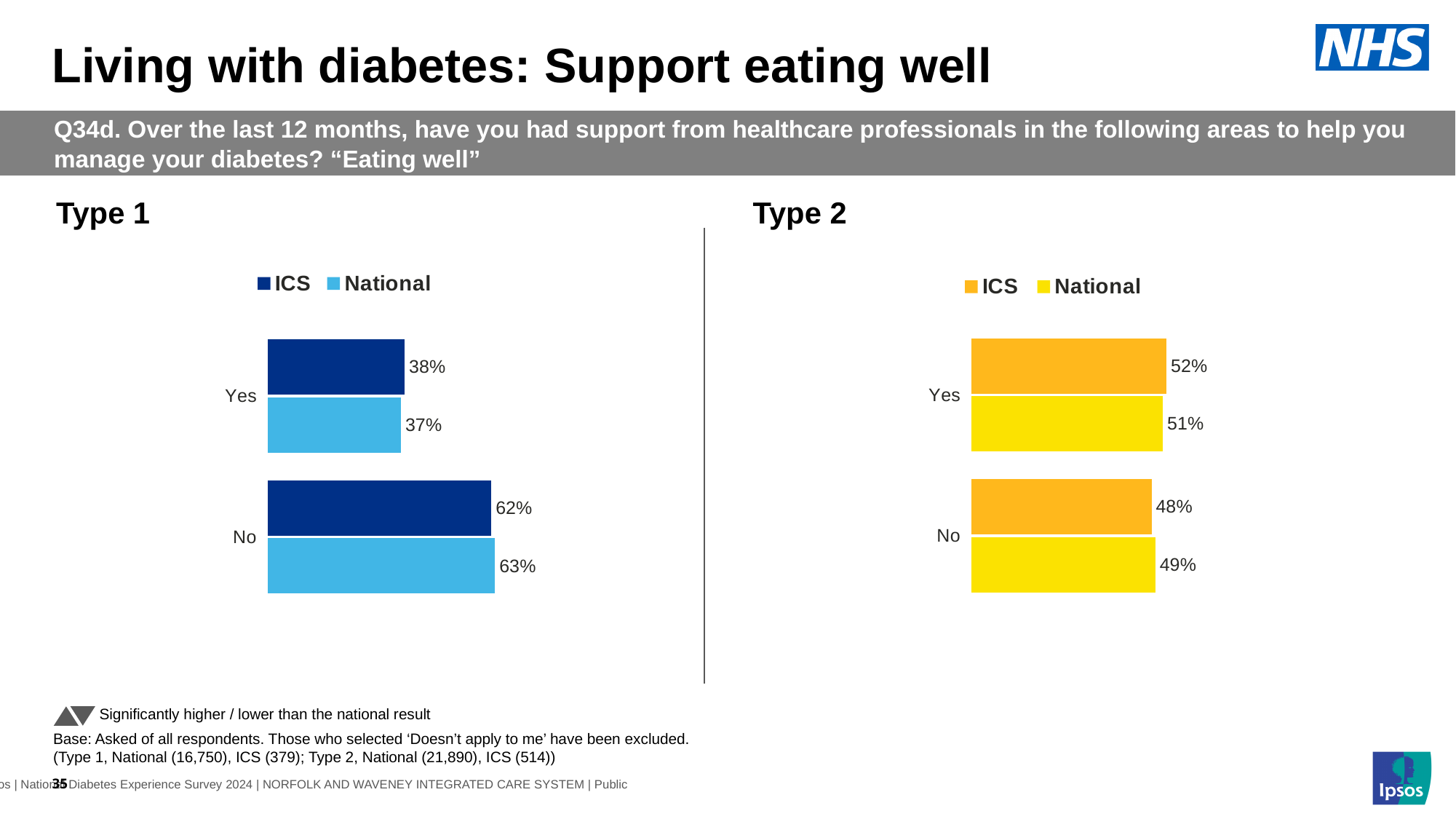
In the Type 2 chart, what is the National value for No? 49% In the Type 1 chart, what is the ICS value for Yes? 38% In the Type 2 chart, what colour are the National bars? Yellow In the Type 2 chart, what is the ICS value for Yes? 52% How many categories are shown in the Type 1 chart? 2 How many series does the legend of the Type 2 chart list? 2 In the Type 2 chart, what is the difference between the ICS values for Yes and No? 4 percentage points In the Type 2 chart, which category has the higher ICS value, Yes or No? Yes In the Type 1 chart, what is the National value for No? 63% What kind of chart is the Type 1 chart? Bar chart In the Type 1 chart, what is the difference between the ICS values for No and Yes? 24 percentage points In the Type 1 chart, which category has the higher National value, Yes or No? No